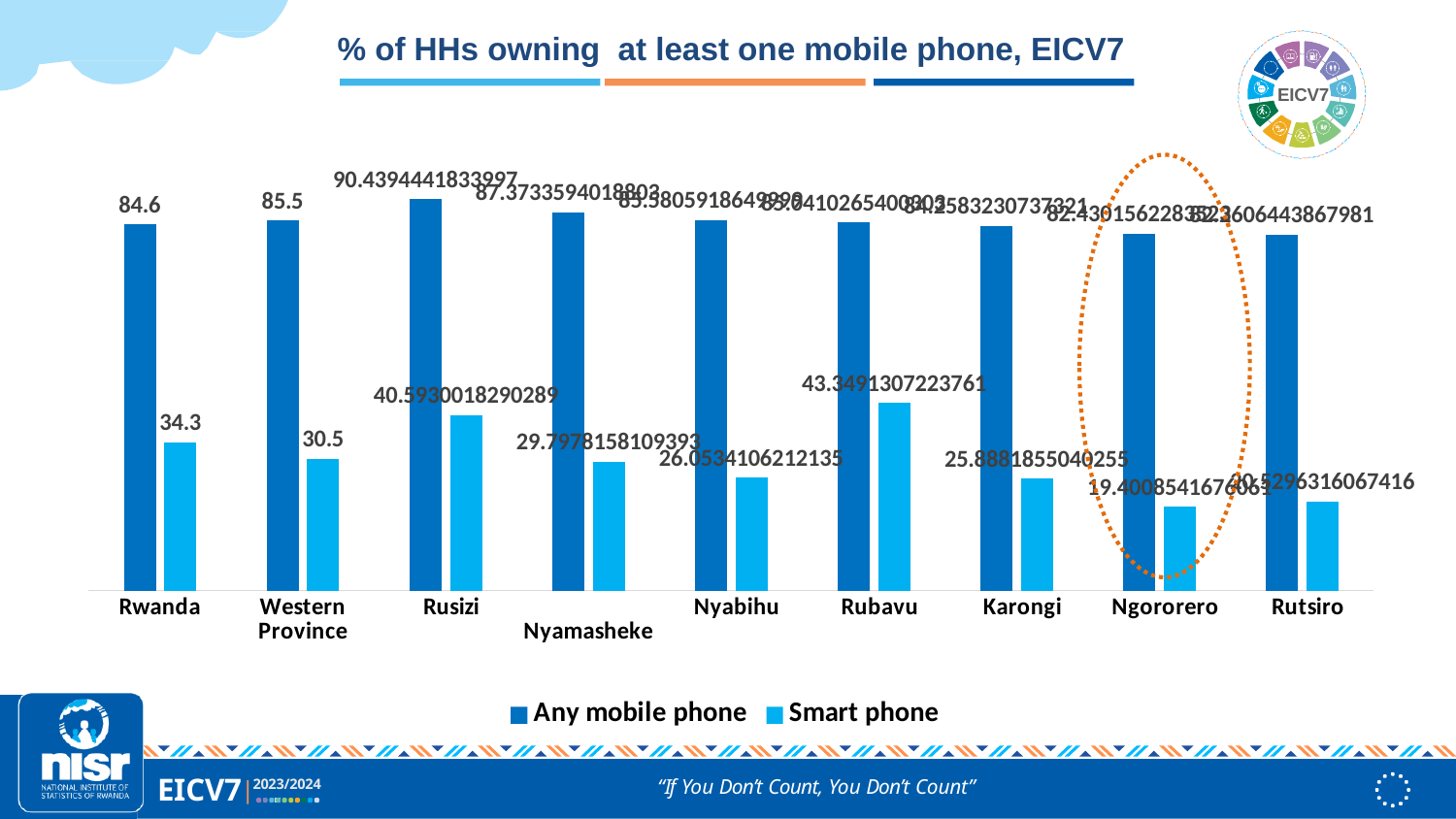
How many categories are shown on the x axis? 9 How many series does the legend list? 2 Which has a larger Smart phone value, Rwanda or Western Province? Rwanda What is the value for Smart phone in Rubavu? 43.3491307223761 What is the value for Any mobile phone in Rwanda? 84.6 Which category has the highest value for Any mobile phone? Rusizi Which category is highlighted with a dashed orange oval? Ngororero What is the difference between the Any mobile phone and Smart phone values for Rwanda? 50.3 What is the value for Smart phone in Western Province? 30.5 What is the value for Smart phone in Nyabihu? 26.0534106212135 Which category has the highest value for Smart phone? Rubavu What kind of chart is shown on the slide? Bar chart